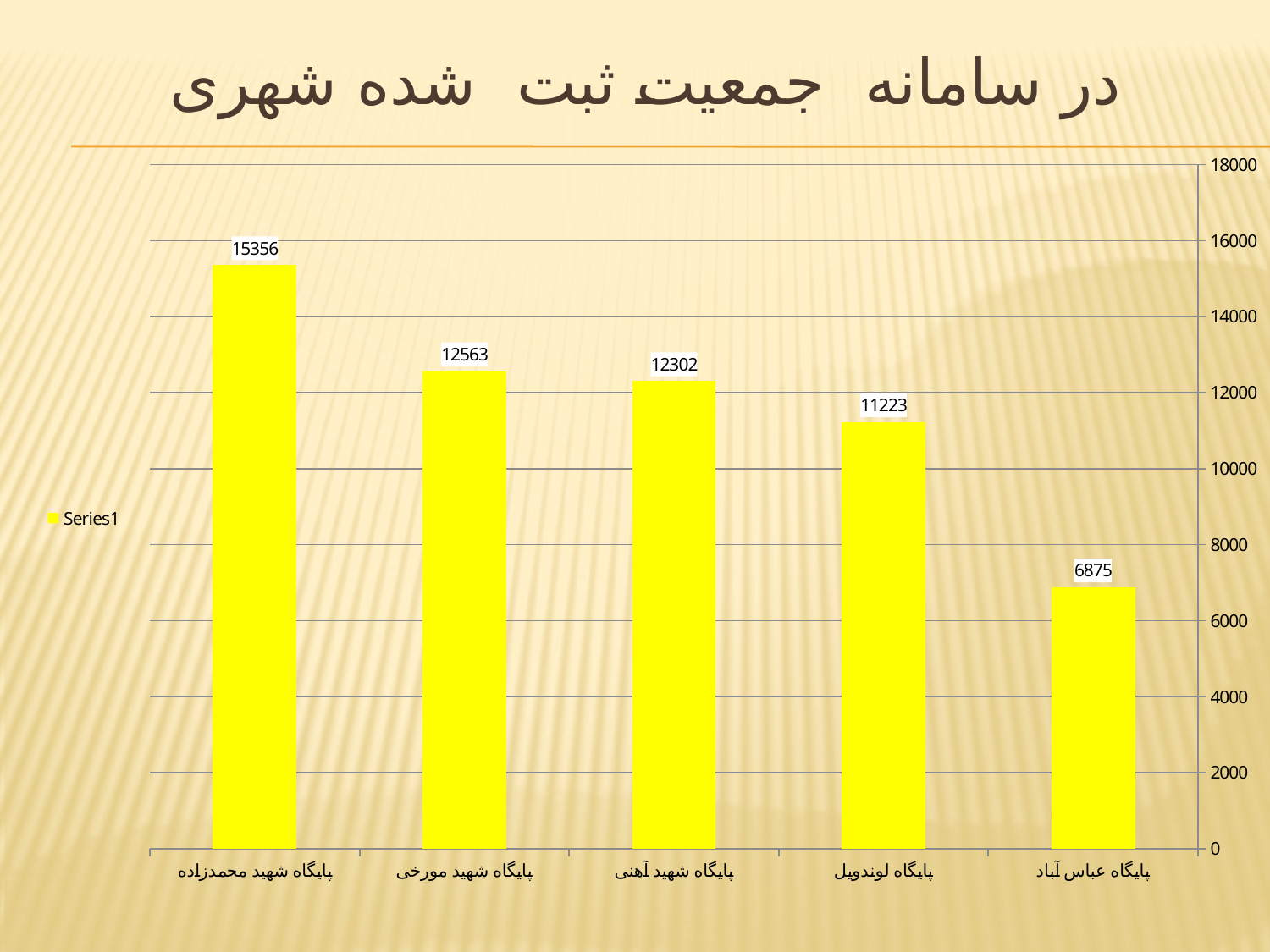
What is the difference between the values for پایگاه شهید محمدزاده and پایگاه عباس آباد? 8481 What kind of chart is shown on the slide? bar chart How many categories are shown on the x axis? 5 What is the value for پایگاه عباس آباد? 6875 Is the value for پایگاه شهید آهنی greater or less than 12000? greater What is the difference between the values for پایگاه شهید مورخی and پایگاه شهید آهنی? 261 What is the value for پایگاه شهید محمدزاده? 15356 Which category has the lowest value? پایگاه عباس آباد What is the value for پایگاه لوندویل? 11223 Which category has the highest value? پایگاه شهید محمدزاده Which is larger, the value for پایگاه لوندویل or the value for پایگاه عباس آباد? پایگاه لوندویل What is the name of the series listed in the legend? Series1